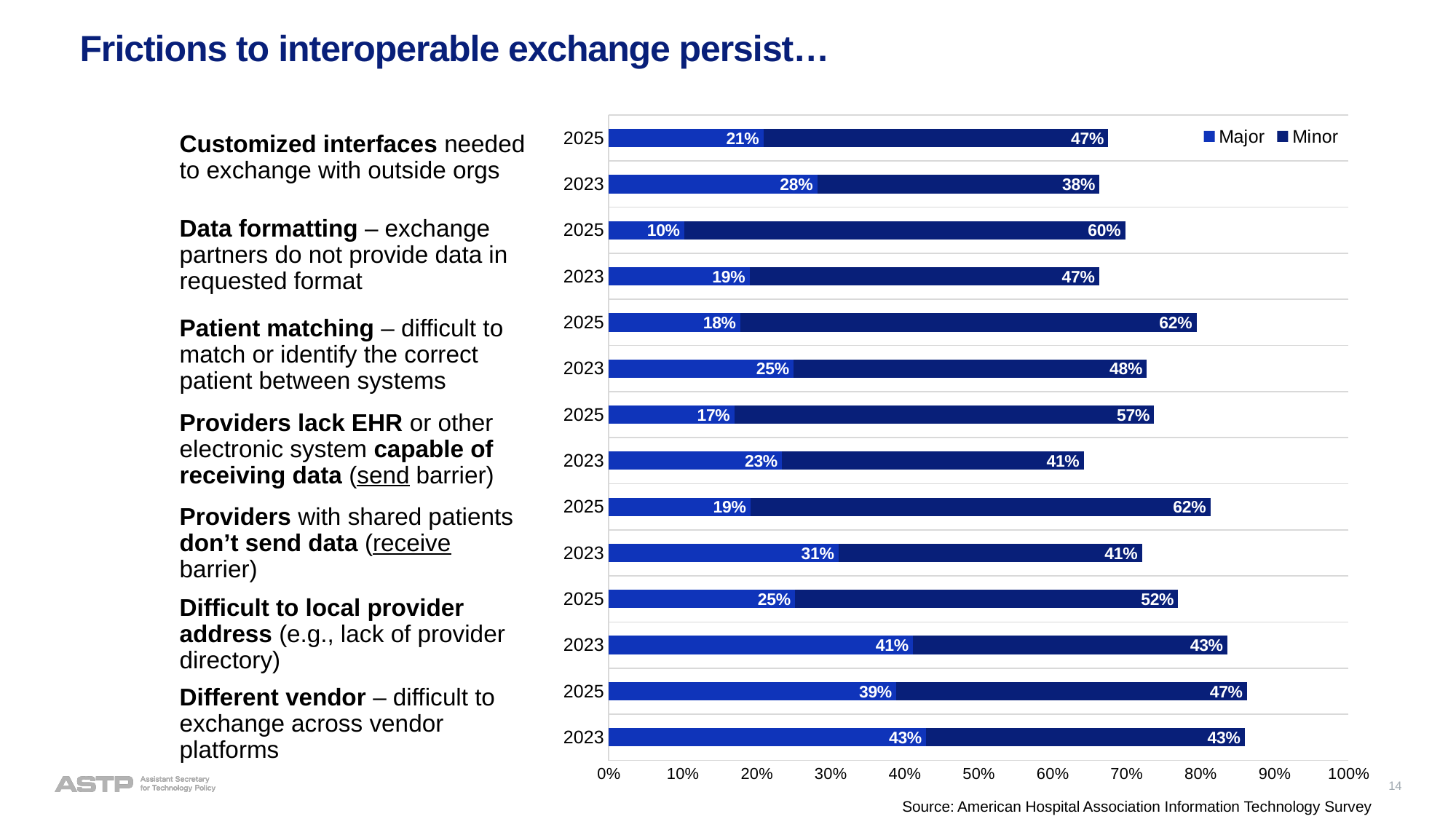
What is the Major value for Different vendor in 2023? 43% What kind of chart is shown on the slide? Stacked bar chart How many bars are plotted in the chart? 14 How many series does the legend list? 2 What are the two series named in the legend? Major and Minor What is the total of the stacked bar for Different vendor in 2023? 86% Which bar has the lowest Major value? Data formatting 2025 What is the total of the stacked bar for Patient matching in 2025? 80% What is the Minor value for Data formatting in 2025? 60% Which is larger, the Major value for Providers with shared patients don't send data in 2023 or in 2025? 2023 What is the difference between the Major values for Difficult to local provider address in 2023 and 2025? 16% What is the Major value for Customized interfaces in 2025? 21%